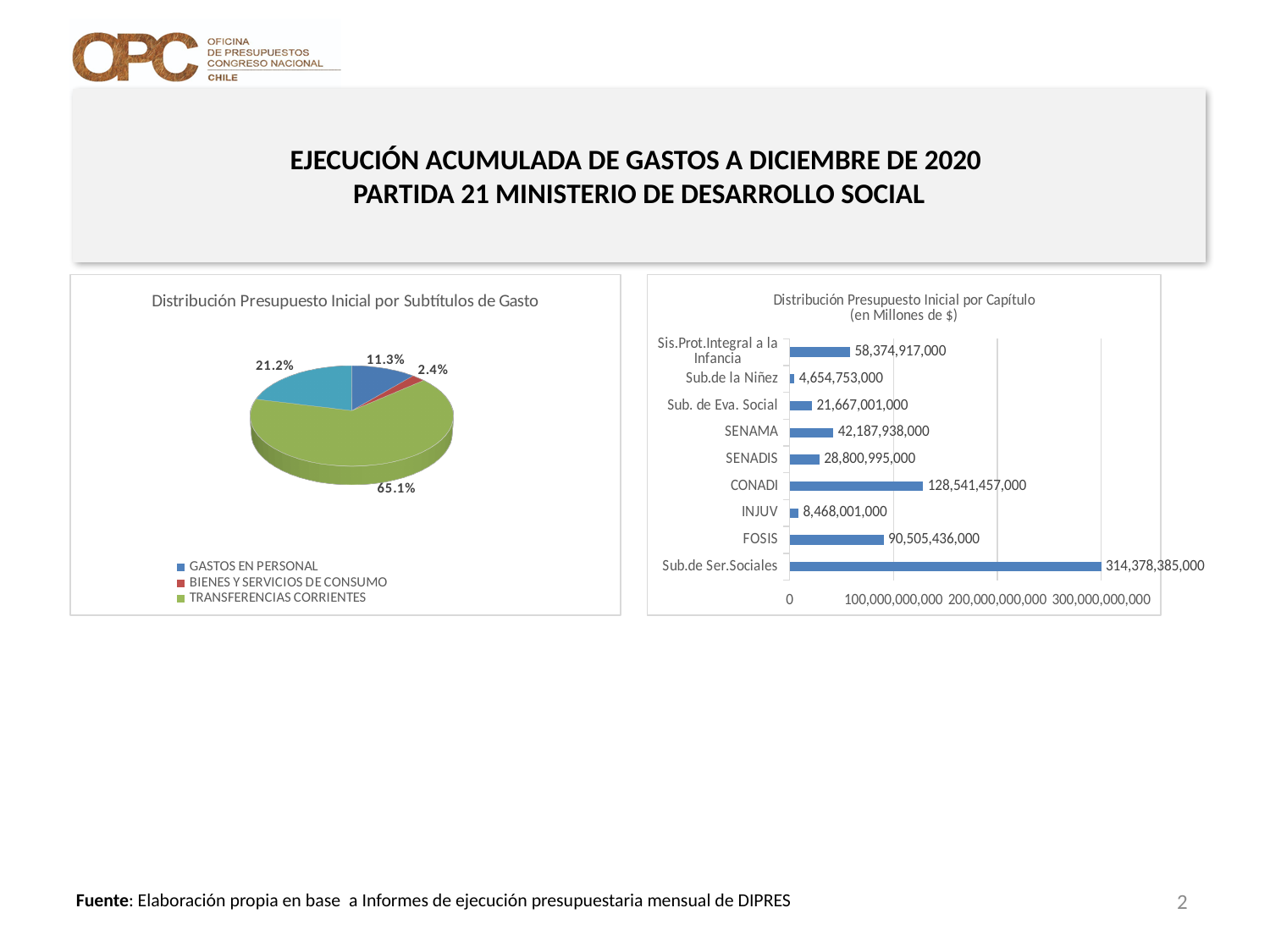
In the chart 'Distribución Presupuesto Inicial por Capítulo', is the value for Sub.de Ser.Sociales greater or less than 300,000,000,000? greater How many entries does the legend of the pie chart 'Distribución Presupuesto Inicial por Subtítulos de Gasto' list? 3 What kind of chart is 'Distribución Presupuesto Inicial por Capítulo'? bar chart In the chart 'Distribución Presupuesto Inicial por Capítulo', which capítulo has the highest value? Sub.de Ser.Sociales In the pie chart 'Distribución Presupuesto Inicial por Subtítulos de Gasto', what share does GASTOS EN PERSONAL have? 11.3% In the pie chart 'Distribución Presupuesto Inicial por Subtítulos de Gasto', what share does TRANSFERENCIAS CORRIENTES have? 65.1% In the chart 'Distribución Presupuesto Inicial por Capítulo', what is the value for CONADI? 128,541,457,000 In the chart 'Distribución Presupuesto Inicial por Capítulo', what is the difference between the values for CONADI and FOSIS? 38,036,021,000 How many capítulos are shown in the chart 'Distribución Presupuesto Inicial por Capítulo'? 9 In the chart 'Distribución Presupuesto Inicial por Capítulo', which is larger, SENAMA or SENADIS? SENAMA In the chart 'Distribución Presupuesto Inicial por Capítulo', what is the value for FOSIS? 90,505,436,000 In the chart 'Distribución Presupuesto Inicial por Capítulo', which capítulo has the lowest value? Sub.de la Niñez